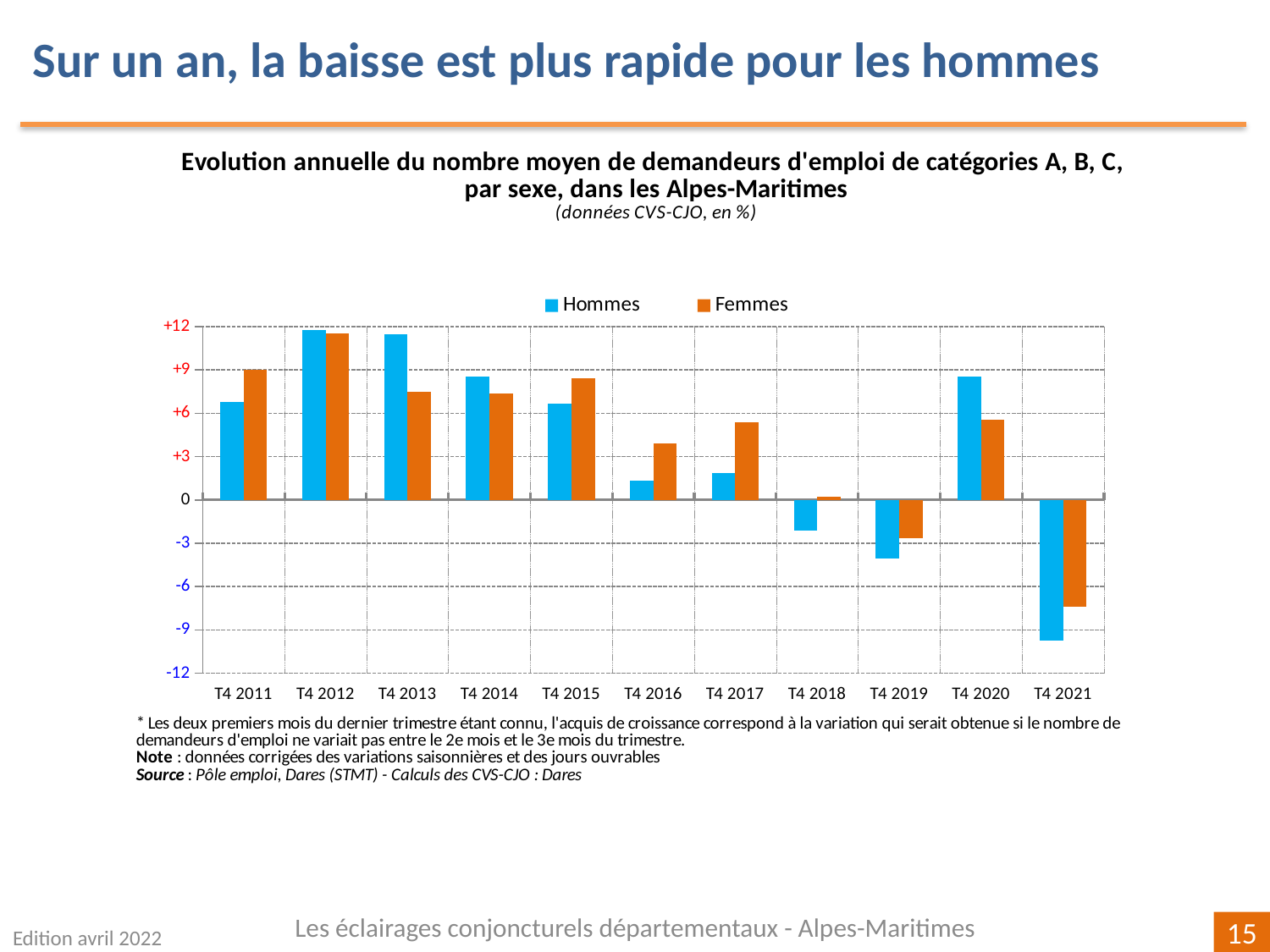
Is the value for Hommes in T4 2019 greater or less than -3? less Which colour represents the Hommes series in the legend? Blue In T4 2011, which series has the larger value, Hommes or Femmes? Femmes Is the value for Femmes in T4 2017 greater or less than +3? greater What kind of chart is shown on the slide? Bar chart How many series does the legend list? 2 For the Femmes series, which quarter has the lowest value? T4 2021 In T4 2021, which series has the larger (less negative) value, Hommes or Femmes? Femmes How many quarters (categories) are shown on the x axis? 11 For the Hommes series, which quarter has the lowest value? T4 2021 For the Femmes series, which quarter has the highest value? T4 2012 Is the value for Hommes in T4 2020 greater or less than +6? greater